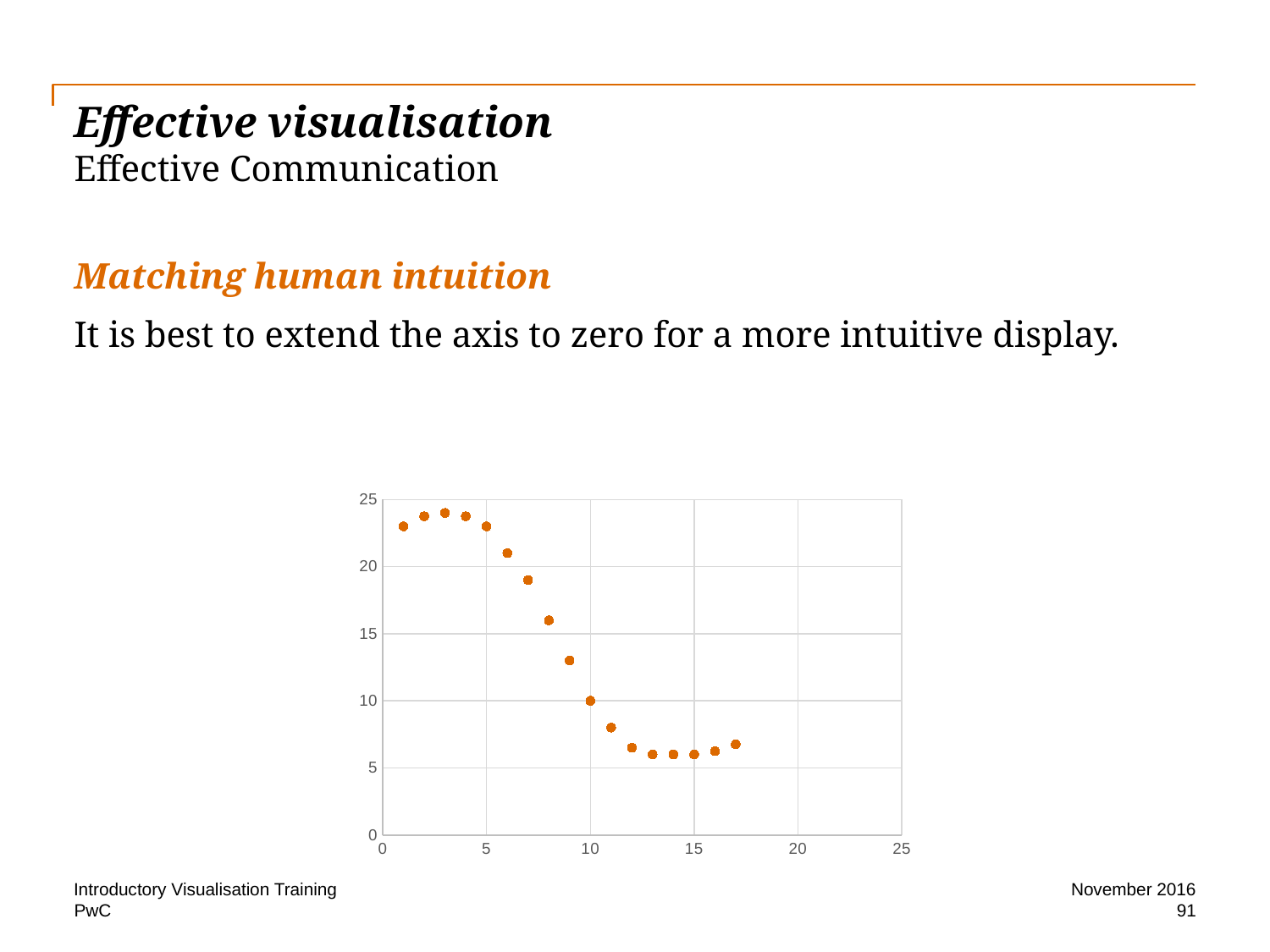
Is the value at x = 1 greater or less than 20? greater Which has the larger value, the point at x = 7 or the point at x = 12? x = 7 Is the value at x = 9 greater or less than 15? less Is the value at x = 8 greater or less than 15? greater Do the plotted values generally rise or fall as x increases from 1 to 15? fall How many data points are plotted on the chart? 17 What kind of chart is shown on the slide? scatter chart Which has the larger value, the point at x = 1 or the point at x = 17? x = 1 What is the highest value shown on the vertical axis? 25